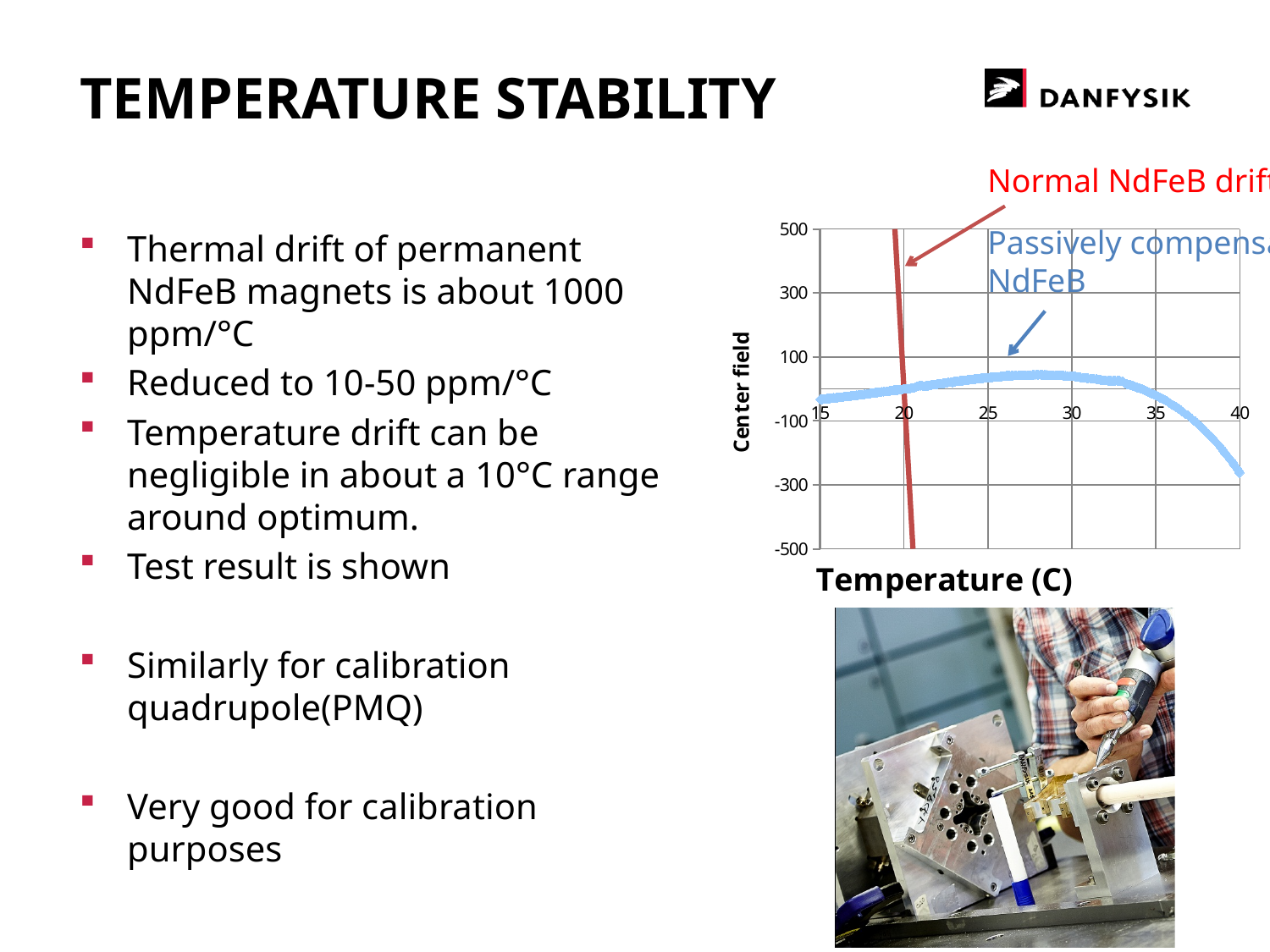
Is the value of the blue (passively compensated NdFeB) curve at 40 C greater or less than -100? less What is the lowest value shown on the y axis of the chart? -500 Which series has the steeper slope on the chart, the red 'Normal NdFeB drift' line or the blue passively compensated curve? Normal NdFeB drift How many lines (series) are plotted on the chart? 2 What is the label of the y axis of the chart? Center field Does the blue (passively compensated NdFeB) curve rise or fall between 35 C and 40 C? fall What is the lowest temperature shown on the x axis of the chart? 15 Is the value of the blue (passively compensated NdFeB) curve at 30 C greater or less than 300? less What kind of chart is shown on the slide? line chart What is the highest temperature shown on the x axis of the chart? 40 What is the label of the x axis of the chart? Temperature (C) What is the highest value shown on the y axis of the chart? 500